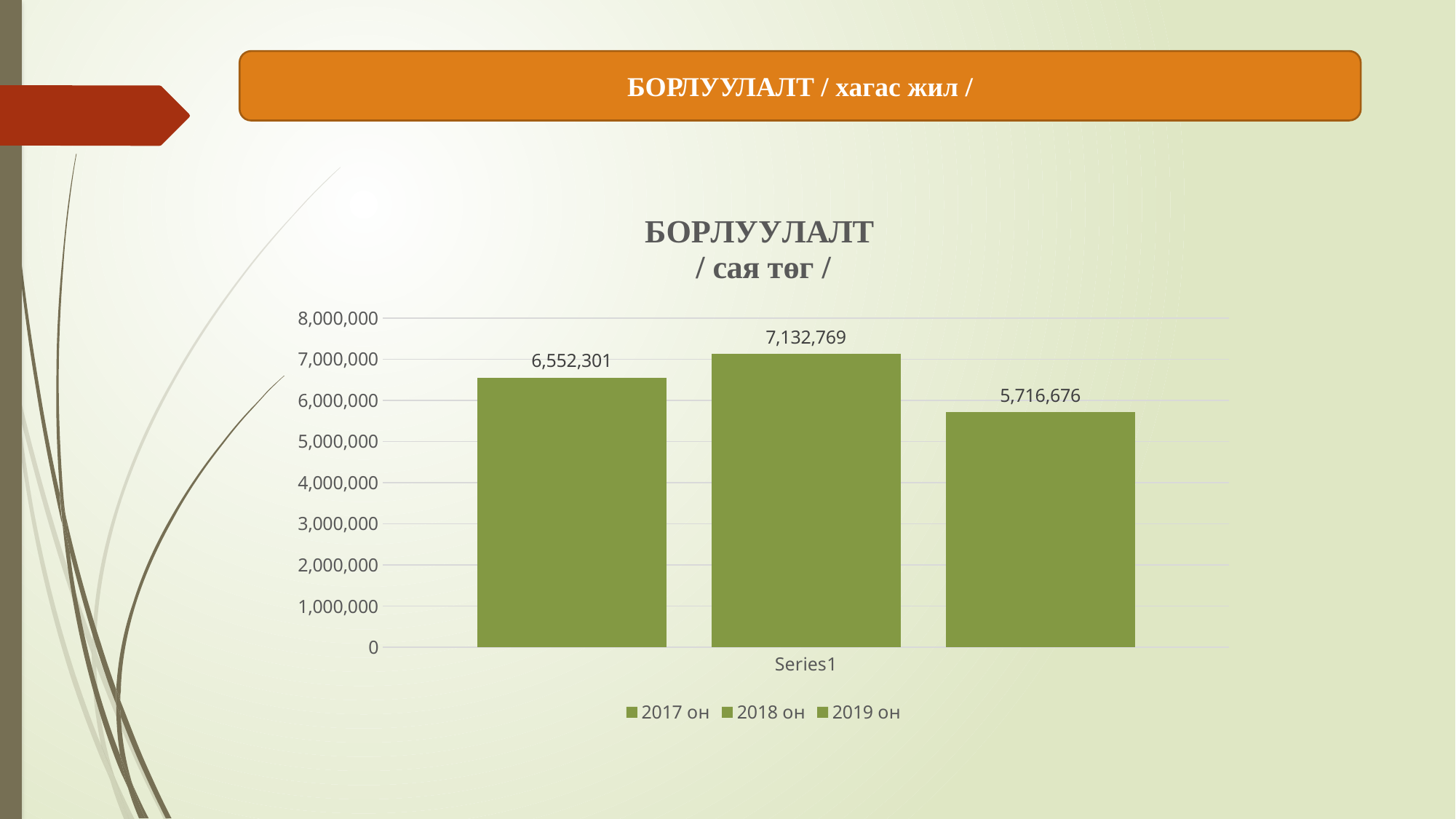
What is the value for 2017 он? 6,552,301 What is the difference between the values for 2018 он and 2017 он? 580,468 How many series does the legend list? 3 How many bars are plotted in the chart? 3 Which year has the highest value? 2018 он What is the value for 2018 он? 7,132,769 What is the difference between the values for 2017 он and 2019 он? 835,625 What kind of chart is shown on the slide? Bar chart Which is larger, the value for 2017 он or the value for 2019 он? 2017 он What is the value for 2019 он? 5,716,676 Which year has the lowest value? 2019 он Is the value for 2018 он greater or less than 7,000,000? greater